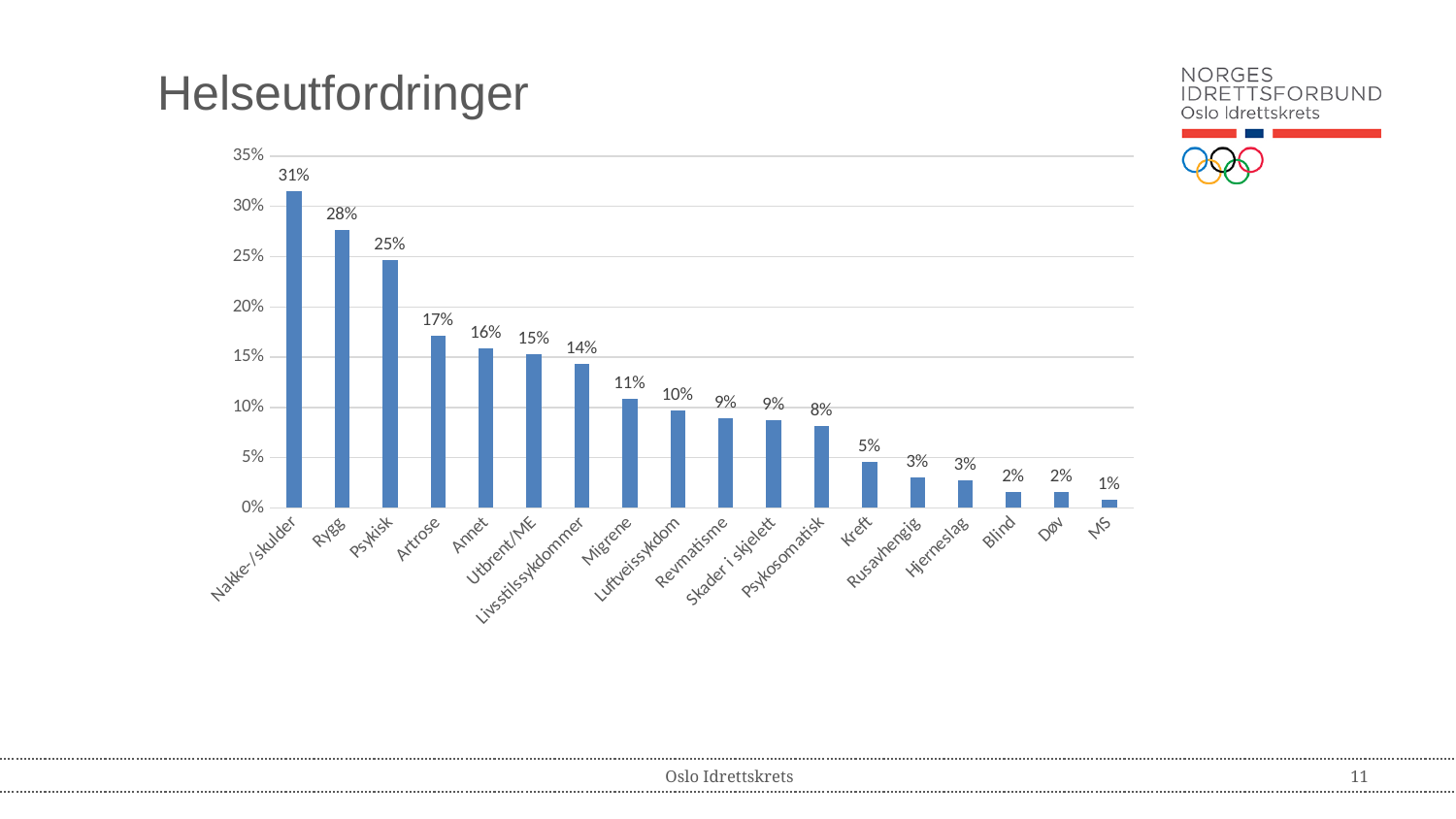
What is the value for Nakke-/skulder? 31% Which is larger, the value for Annet or the value for Luftveissykdom? Annet What kind of chart is shown on the slide? Bar chart Which category has the lowest value? MS How many categories are shown on the x axis? 18 What is the value for Psykisk? 25% Is the value for Livsstilssykdommer greater or less than 10%? greater What is the value for Kreft? 5% What is the title of the slide? Helseutfordringer What is the difference between the values for Rygg and Artrose? 11% Which category has the highest value? Nakke-/skulder What is the value for Migrene? 11%